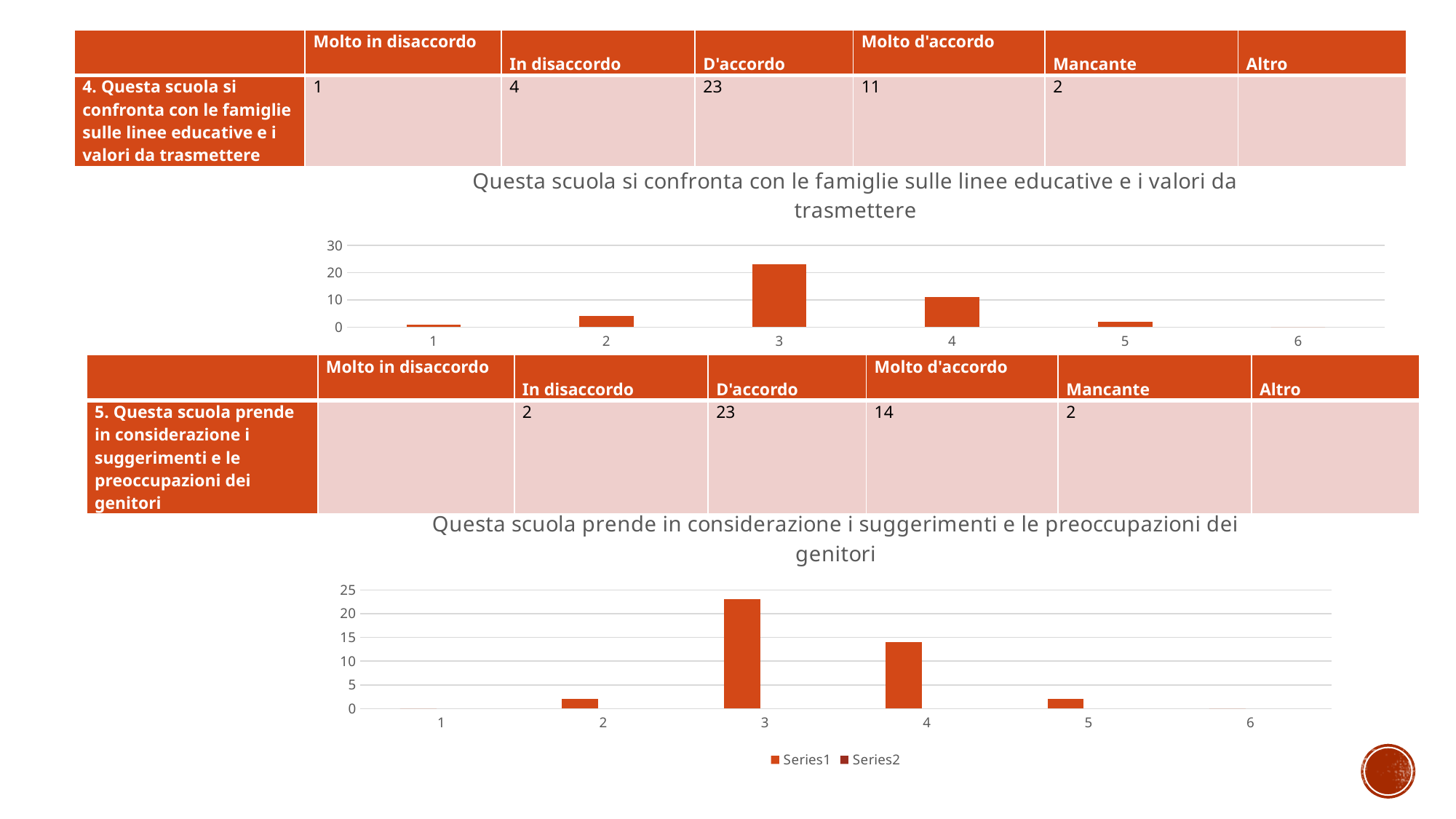
In the top chart ("Questa scuola si confronta con le famiglie..."), is the value for category 4 greater or less than 10? greater In the bottom chart ("Questa scuola prende in considerazione i suggerimenti..."), what is the value for category 4 (Molto d'accordo), as shown in the table above it? 14 In the bottom chart ("Questa scuola prende in considerazione i suggerimenti..."), what is the difference between the values for category 3 (23) and category 4 (14)? 9 In the top chart ("Questa scuola si confronta con le famiglie..."), what is the value for category 3 (D'accordo), as shown in the table above it? 23 In the bottom chart ("Questa scuola prende in considerazione i suggerimenti..."), which category has the tallest bar? 3 In the top chart ("Questa scuola si confronta con le famiglie..."), which has the larger value, category 4 or category 5? 4 In the top chart ("Questa scuola si confronta con le famiglie..."), which category on the x axis has the tallest bar? 3 How many categories are shown on the x axis of the top chart ("Questa scuola si confronta con le famiglie...")? 6 How many series does the legend of the bottom chart ("Questa scuola prende in considerazione i suggerimenti...") list? 2 In the bottom chart ("Questa scuola prende in considerazione i suggerimenti..."), is the value for category 3 greater or less than 20? greater What kind of chart is the top chart titled "Questa scuola si confronta con le famiglie sulle linee educative e i valori da trasmettere"? bar chart In the top chart ("Questa scuola si confronta con le famiglie..."), is the value for category 2 greater or less than 10? less